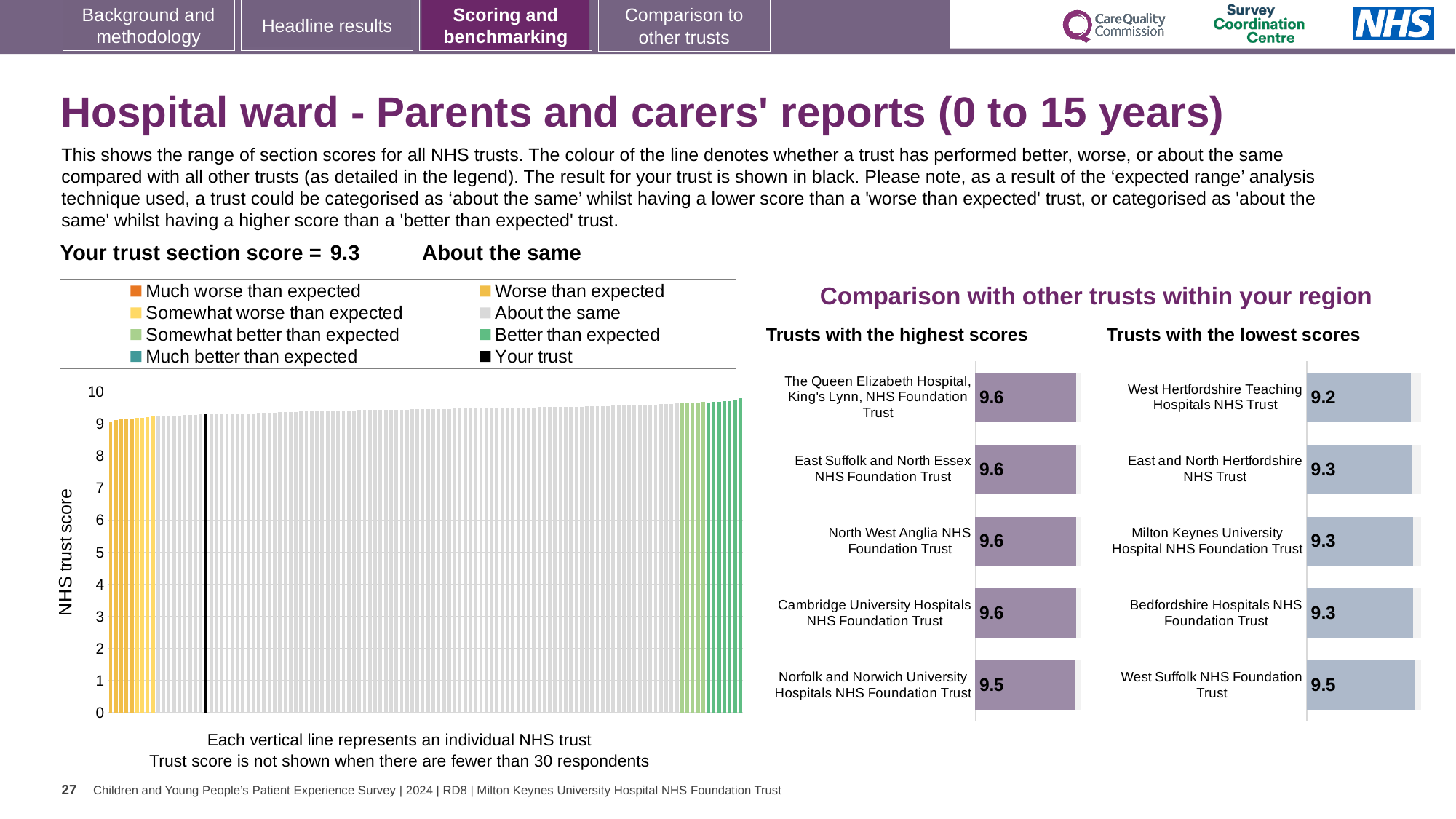
In the 'Trusts with the lowest scores' chart, which trust has the highest score? West Suffolk NHS Foundation Trust In the large chart on the left, do the trust scores rise or fall from left to right along the x axis? Rise In the 'Trusts with the lowest scores' chart, which has the larger score: Milton Keynes University Hospital NHS Foundation Trust or West Suffolk NHS Foundation Trust? West Suffolk NHS Foundation Trust In the 'Trusts with the highest scores' chart, what is the score for The Queen Elizabeth Hospital, King's Lynn, NHS Foundation Trust? 9.6 What kind of chart is the large chart on the left showing NHS trust scores? Bar chart In the 'Trusts with the highest scores' chart, which trust has the lowest score? Norfolk and Norwich University Hospitals NHS Foundation Trust How many entries does the legend above the large chart on the left list? 8 In the 'Trusts with the lowest scores' chart, what is the difference between the scores of West Suffolk NHS Foundation Trust and West Hertfordshire Teaching Hospitals NHS Trust? 0.3 In the 'Trusts with the highest scores' chart, what is the score for Norfolk and Norwich University Hospitals NHS Foundation Trust? 9.5 In the 'Trusts with the highest scores' chart, how many trusts are listed? 5 In the 'Trusts with the lowest scores' chart, what is the score for West Hertfordshire Teaching Hospitals NHS Trust? 9.2 In the 'Trusts with the lowest scores' chart, which trust has the lowest score? West Hertfordshire Teaching Hospitals NHS Trust